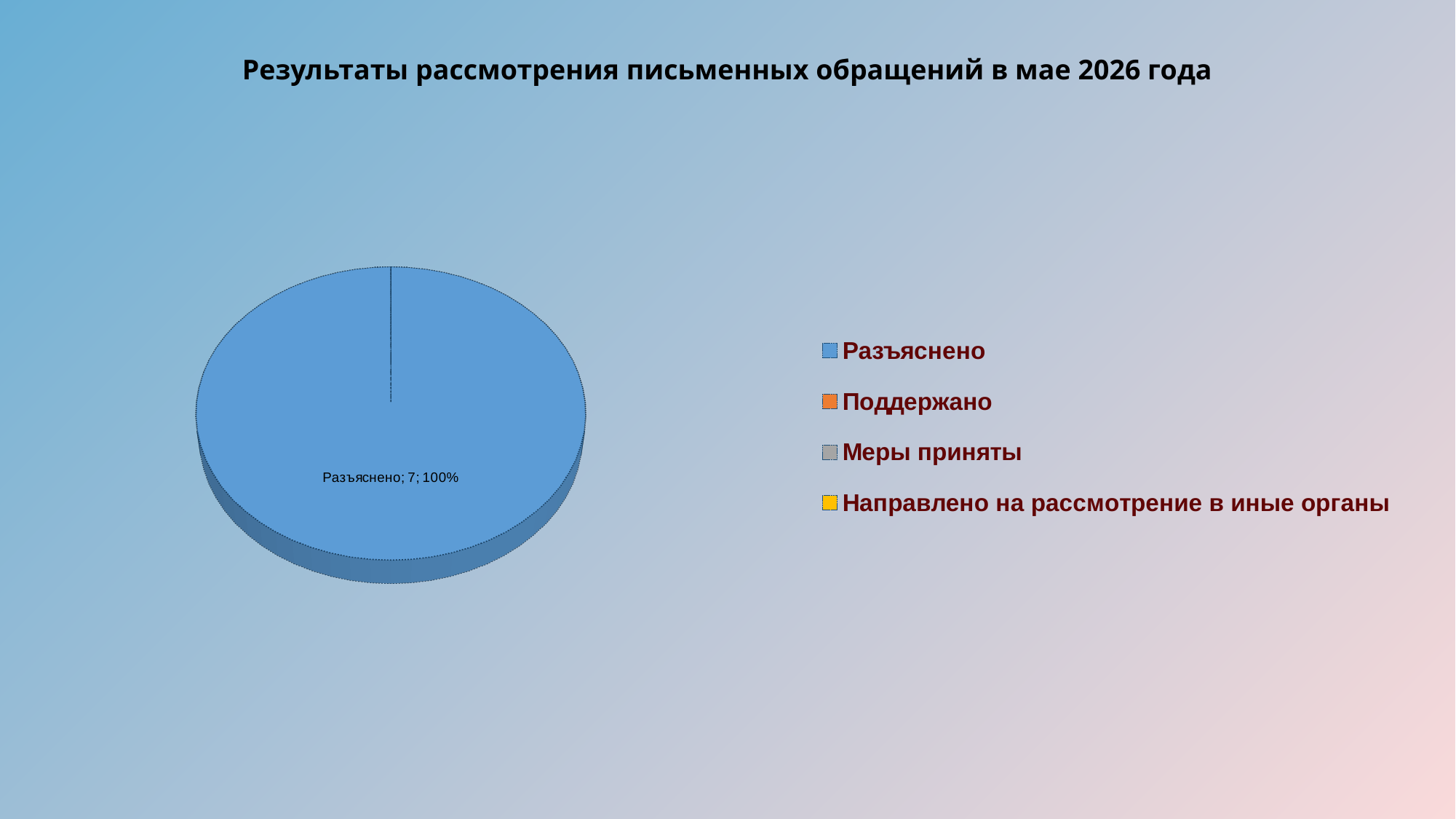
How many entries does the legend list? 4 Is the value for Разъяснено greater or less than 5? greater Which legend entry is listed last? Направлено на рассмотрение в иные органы How many slices are visible in the pie? 1 What share of the pie does the Разъяснено slice represent? 100% Which category has the largest slice of the pie? Разъяснено What kind of chart is shown on the slide? pie chart What value is shown for the Разъяснено slice? 7 What colour is the Разъяснено slice? blue What is the title of the chart? Результаты рассмотрения письменных обращений в мае 2026 года